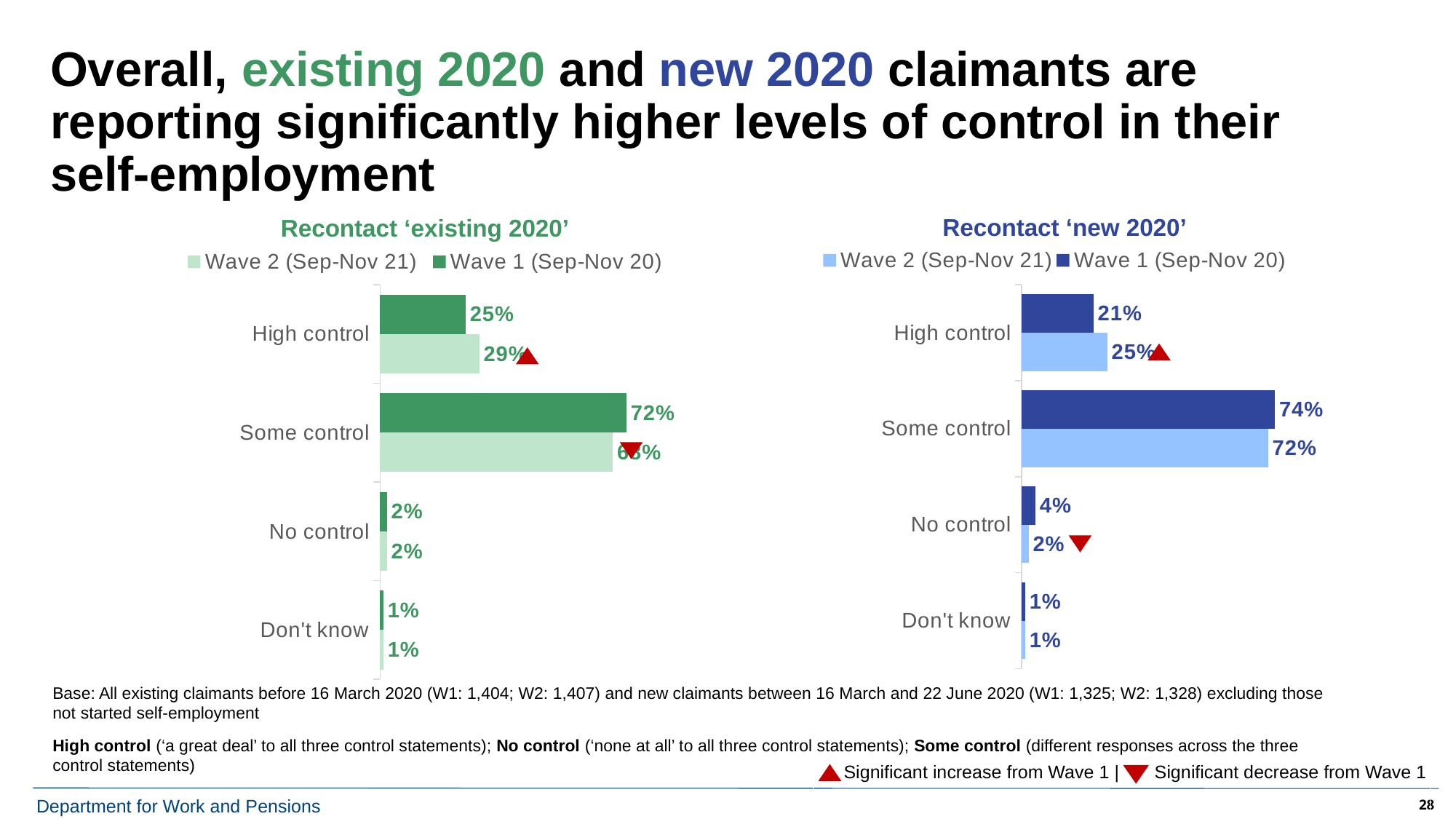
In the 'Recontact ‘new 2020’' chart, is the Wave 1 (Sep-Nov 20) value for No control larger or smaller than the Wave 2 (Sep-Nov 21) value? larger How many series does the legend of the 'Recontact ‘new 2020’' chart list? 2 In the 'Recontact ‘existing 2020’' chart, which category has the lowest Wave 1 (Sep-Nov 20) value? Don't know In the 'Recontact ‘existing 2020’' chart, what is the Wave 1 (Sep-Nov 20) value for High control? 25% In the 'Recontact ‘new 2020’' chart, what is the Wave 1 (Sep-Nov 20) value for Some control? 74% In the 'Recontact ‘existing 2020’' chart, what is the Wave 2 (Sep-Nov 21) value for High control? 29% In the 'Recontact ‘new 2020’' chart, which category has the highest Wave 2 (Sep-Nov 21) value? Some control In the 'Recontact ‘new 2020’' chart, what is the Wave 2 (Sep-Nov 21) value for No control? 2% In the 'Recontact ‘new 2020’' chart, what is the difference between the Wave 2 and Wave 1 values for High control? 4 percentage points In the 'Recontact ‘existing 2020’' chart, what is the Wave 1 (Sep-Nov 20) value for Some control? 72% What type of chart is the 'Recontact ‘existing 2020’' chart? Bar chart How many categories are shown in the 'Recontact ‘existing 2020’' chart? 4